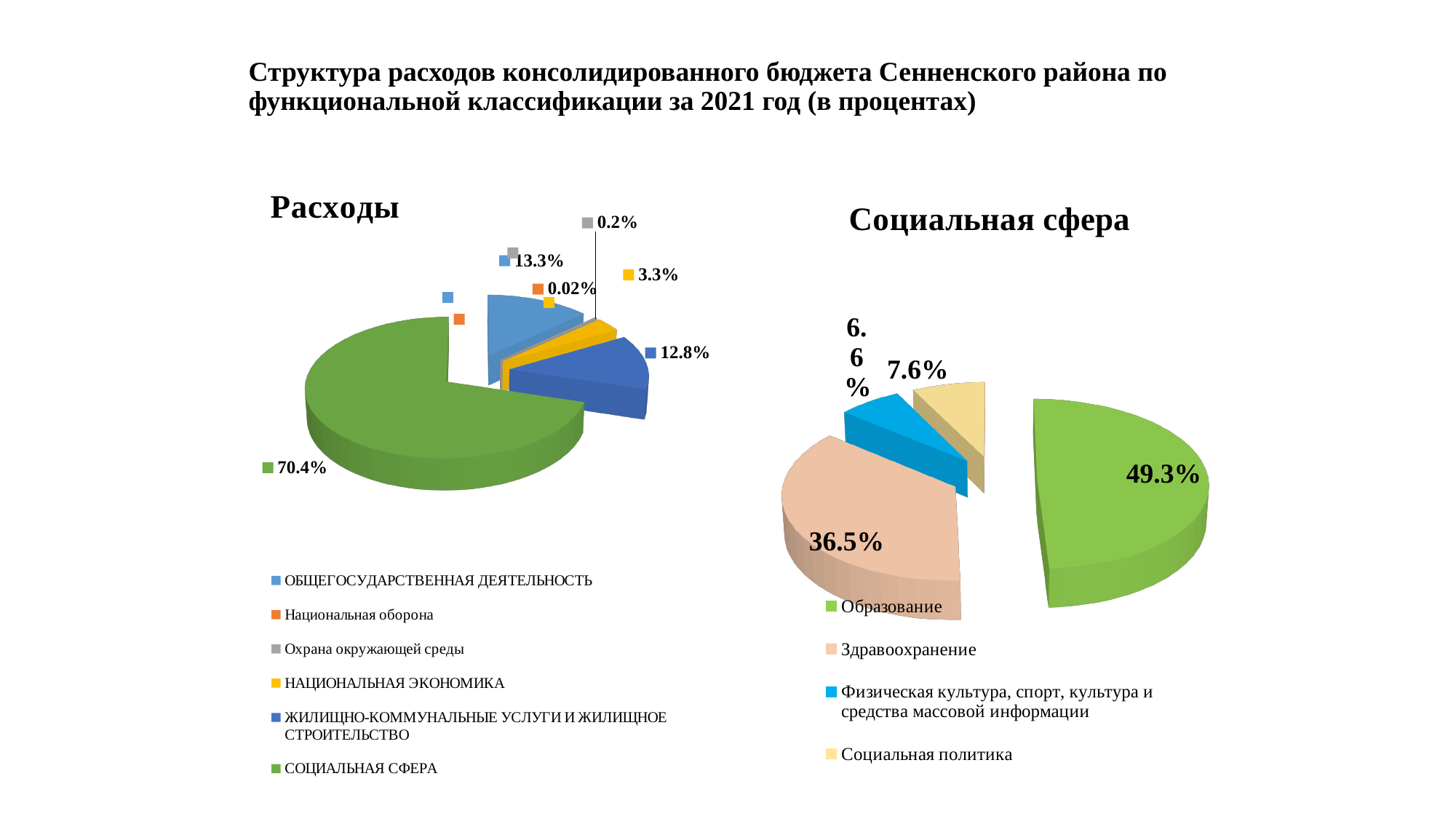
In the 'Расходы' chart, what share is shown for Национальная оборона? 0.02% In the 'Социальная сфера' chart, what share is shown for Социальная политика? 7.6% What type of chart is the 'Социальная сфера' chart? Pie chart In the 'Социальная сфера' chart, what share is shown for Здравоохранение? 36.5% In the 'Социальная сфера' chart, which category has the largest share? Образование In the 'Расходы' chart, how many categories does the legend list? 6 In the 'Расходы' chart, what share is shown for ЖИЛИЩНО-КОММУНАЛЬНЫЕ УСЛУГИ И ЖИЛИЩНОЕ СТРОИТЕЛЬСТВО? 12.8% In the 'Социальная сфера' chart, what is the difference between the shares of Образование and Здравоохранение? 12.8% In the 'Расходы' chart, which category has the largest share? СОЦИАЛЬНАЯ СФЕРА In the 'Расходы' chart, what share is shown for СОЦИАЛЬНАЯ СФЕРА? 70.4% In the 'Расходы' chart, which category has the smallest share? Национальная оборона In the 'Расходы' chart, which is larger: ОБЩЕГОСУДАРСТВЕННАЯ ДЕЯТЕЛЬНОСТЬ or НАЦИОНАЛЬНАЯ ЭКОНОМИКА? ОБЩЕГОСУДАРСТВЕННАЯ ДЕЯТЕЛЬНОСТЬ